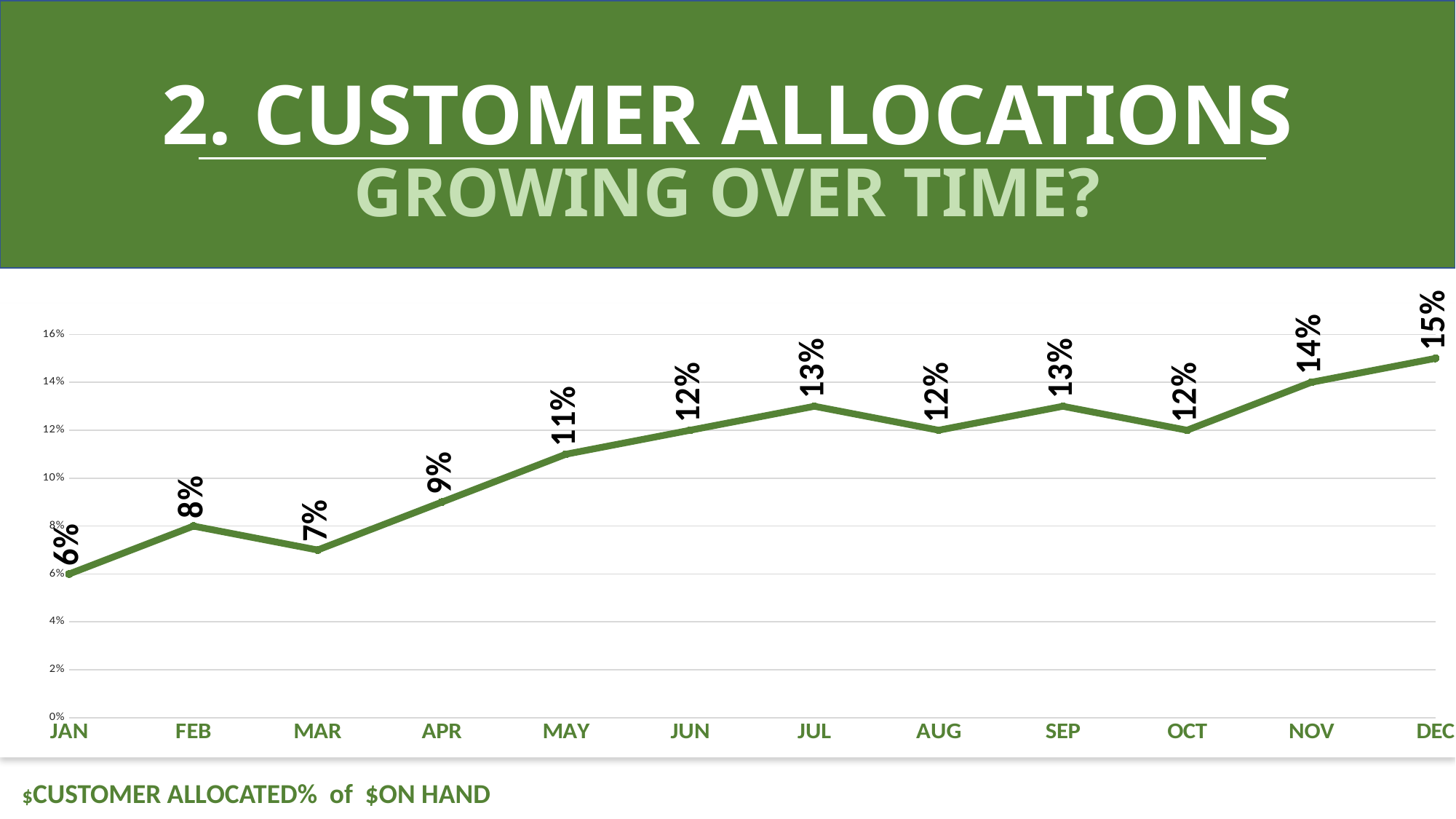
Which month has the lowest value? JAN What is the value for MAY? 11% What kind of chart is shown on the slide? line chart What is the value for JAN? 6% Which is larger, the value for FEB or the value for MAR? FEB What is the value for NOV? 14% Is the value for JUL greater or less than 10%? greater What is the difference between the values for DEC and JAN? 9% What is the label shown below the chart describing the plotted measure? $CUSTOMER ALLOCATED% of $ON HAND How many months are plotted on the x axis? 12 Do the values generally rise or fall from JAN to DEC? rise Which month has the highest value? DEC